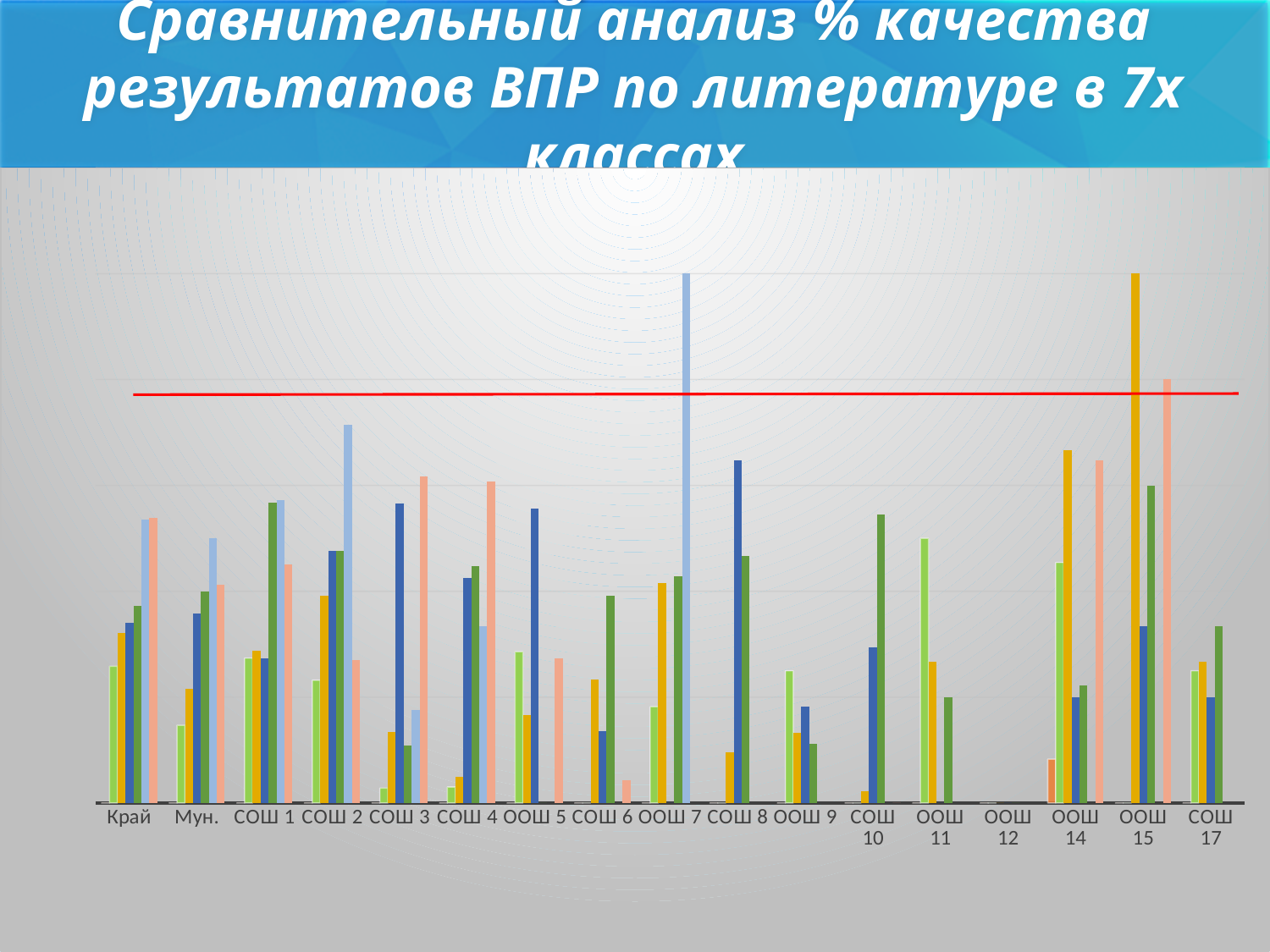
How many categories are shown along the x axis of the chart? 17 Which is taller: the salmon bar for СОШ 3 or the salmon bar for СОШ 6? СОШ 3 What is the last category on the x axis of the chart? СОШ 17 Which is taller: the dark blue bar for СОШ 8 or the dark blue bar for СОШ 6? СОШ 8 Within the Край category, which is taller: the light blue bar or the dark green bar? light blue Which category on the x axis has no bars plotted at all? ООШ 12 What is the first category on the x axis of the chart? Край What kind of chart is shown on the slide? bar chart